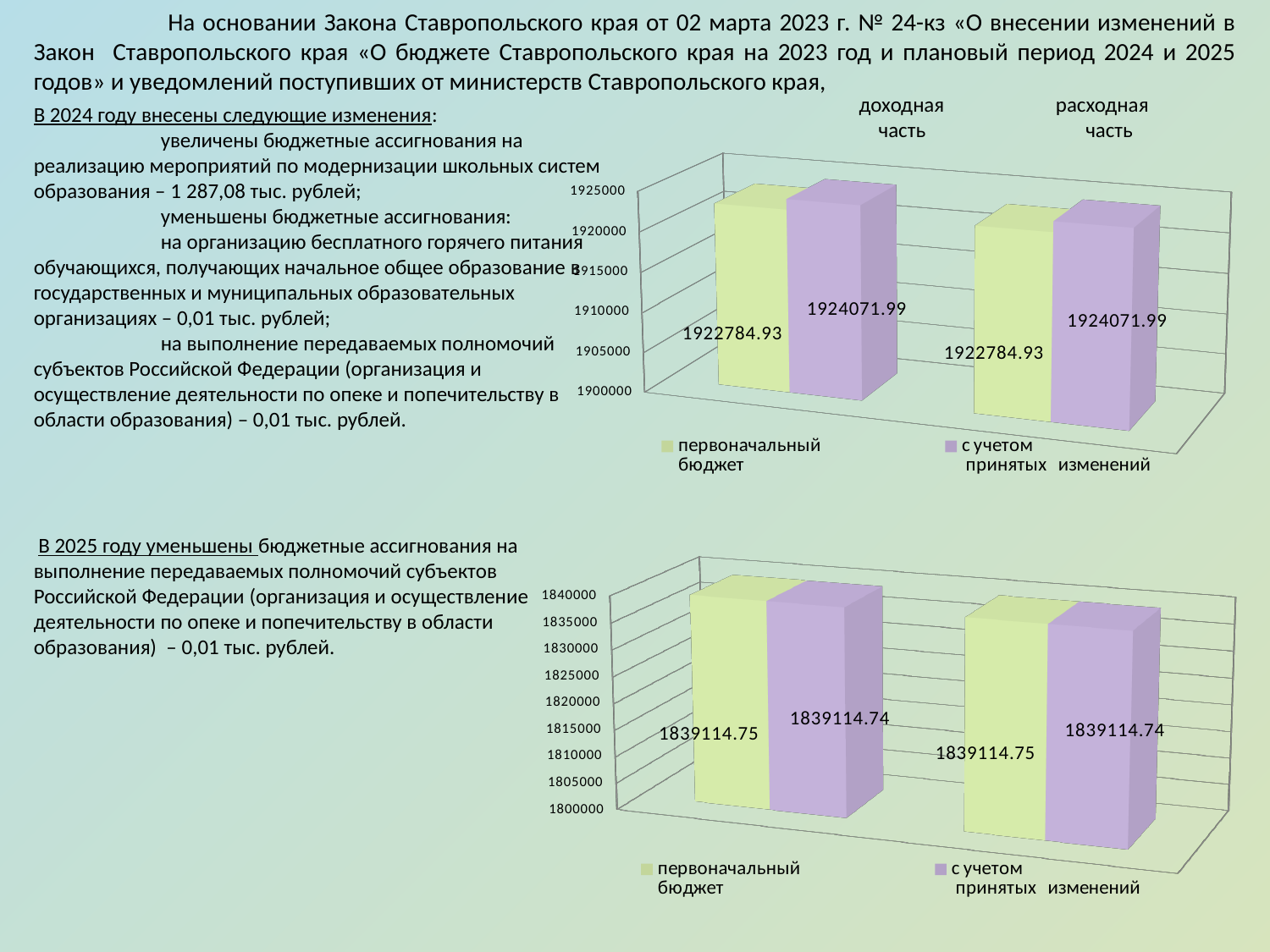
How many series does the legend of the top chart list? 2 In the top chart, which series has the larger value for 'доходная часть': 'первоначальный бюджет' or 'с учетом принятых изменений'? с учетом принятых изменений In the top chart, is the 'первоначальный бюджет' value for 'доходная часть' greater or less than 1910000? greater What kind of chart is the top chart? bar chart How many category groups are shown in the top chart? 2 In the top chart, what is the value of the 'первоначальный бюджет' bar for 'доходная часть'? 1922784.93 In the bottom chart, what is the value of the 'первоначальный бюджет' bar in the left group? 1839114.75 In the top chart, what is the value of the 'с учетом принятых изменений' bar for 'расходная часть'? 1924071.99 In the bottom chart, what is the difference between the 'первоначальный бюджет' and 'с учетом принятых изменений' values in the left group? 0.01 In the bottom chart, what is the value of the 'с учетом принятых изменений' bar in the right group? 1839114.74 In the top chart, what is the difference between the 'с учетом принятых изменений' and 'первоначальный бюджет' values for 'расходная часть'? 1287.06 In the bottom chart, which legend entry is shown in purple? с учетом принятых изменений